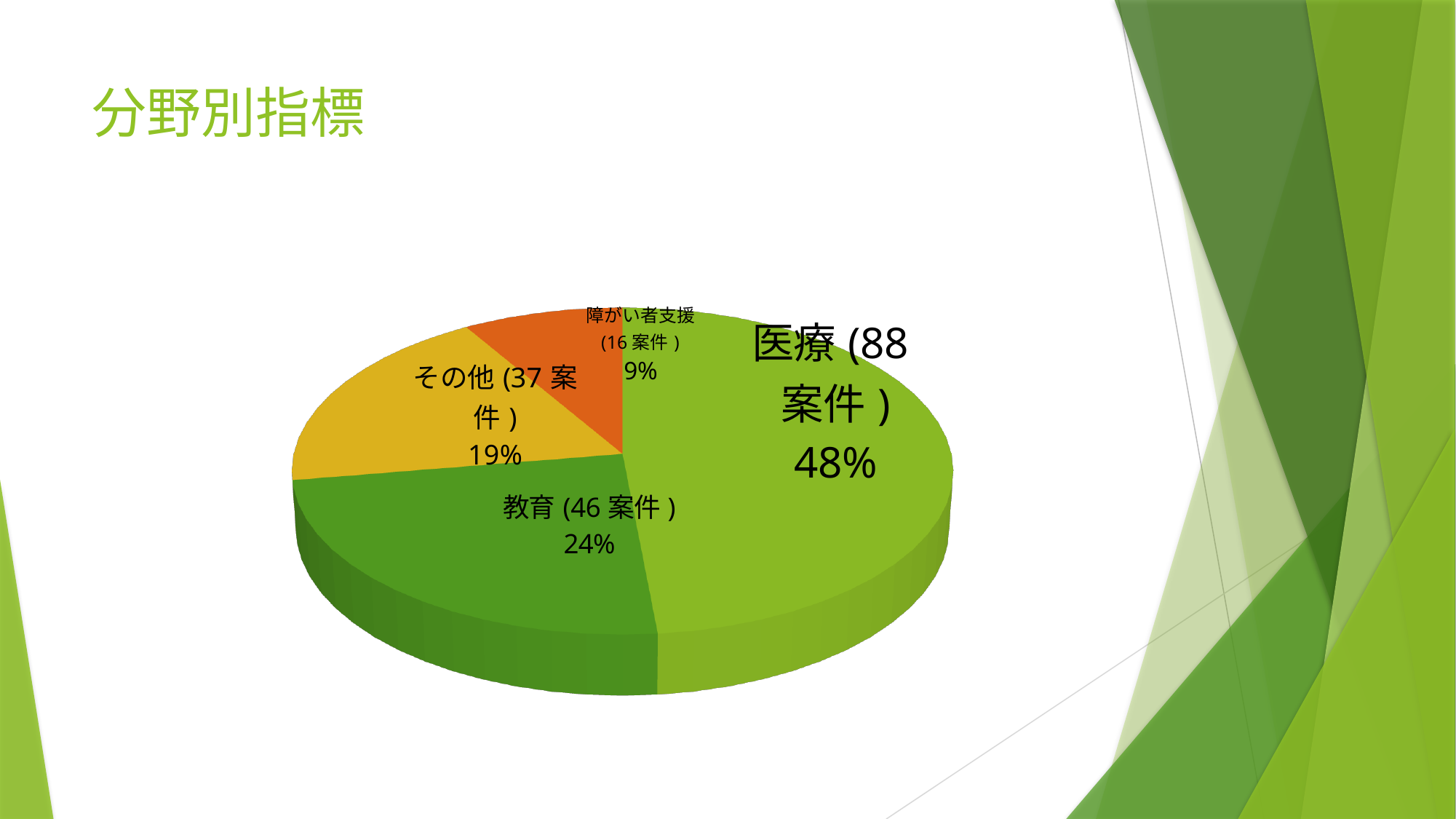
Which category has the largest slice of the pie? 医療 How many 案件 are shown for 障がい者支援? 16 How many categories does the pie chart show? 4 What is the difference in 案件 between 医療 and 教育? 42 How many 案件 are shown for 教育? 46 Which category has the smallest slice of the pie? 障がい者支援 What kind of chart is shown on the slide? pie chart What percentage share does 医療 have in the pie chart? 48% Which has more 案件, その他 or 障がい者支援? その他 What is the title of the slide containing the pie chart? 分野別指標 What is the difference in percentage points between 教育 and その他? 5 What percentage share does その他 have? 19%